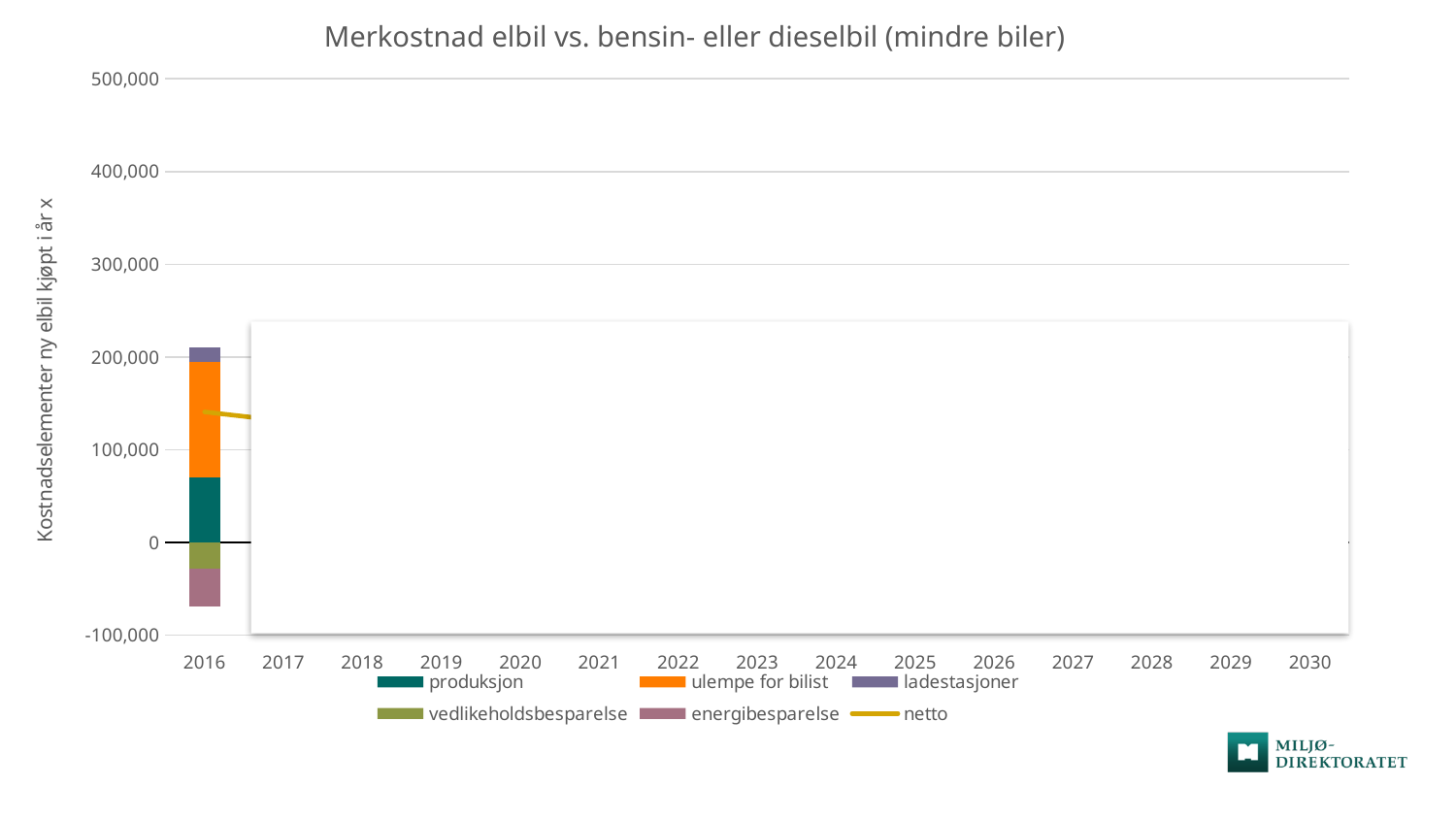
Is the value of the netto line for 2016 greater or less than 100,000? greater Is the produksjon segment for 2016 greater or less than 100,000? less Which year is the last category on the x axis? 2030 What kind of chart is shown on the slide? Stacked bar chart with a line Is the value of the netto line for 2016 greater or less than 200,000? less What is the title of the chart? Merkostnad elbil vs. bensin- eller dieselbil (mindre biler) Which series in the legend is drawn as a line rather than a bar segment? netto Which year is the first category on the x axis? 2016 How many series does the legend list? 6 How many years are shown on the x axis? 15